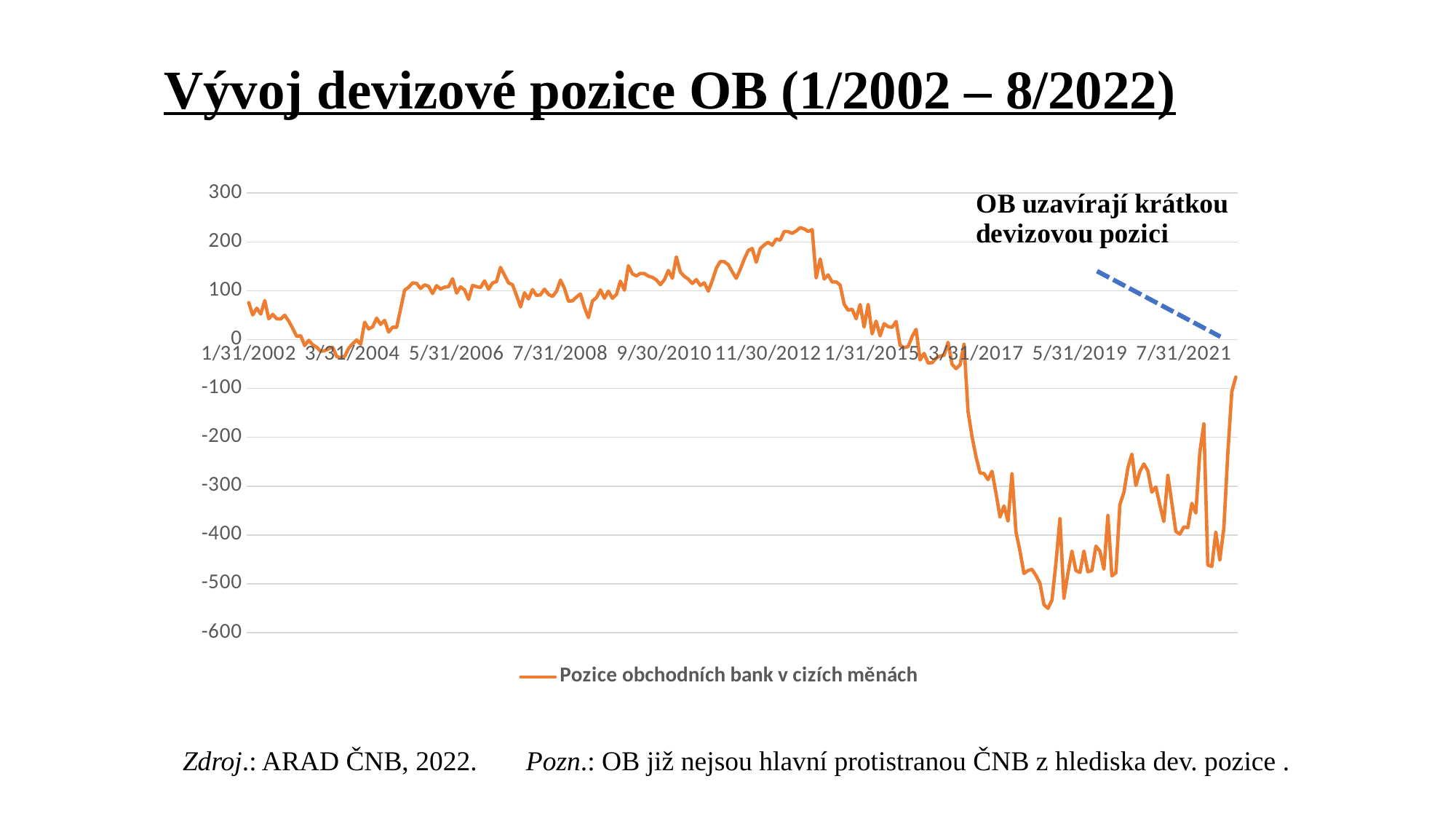
Is the lowest point of the line above or below -500? below What is the legend entry for the plotted series? Pozice obchodních bank v cizích měnách How many series does the legend list? 1 Is the value at 7/31/2021 greater or less than -200? less What is the title of the chart on the slide? Vývoj devizové pozice OB (1/2002 – 8/2022) What is the lowest value shown on the y axis? -600 Does the line rise or fall between 11/30/2012 and 3/31/2017? fall Is the value at 1/31/2002 greater or less than 0? greater What kind of chart is shown on the slide? line chart How many date labels are shown on the x axis? 10